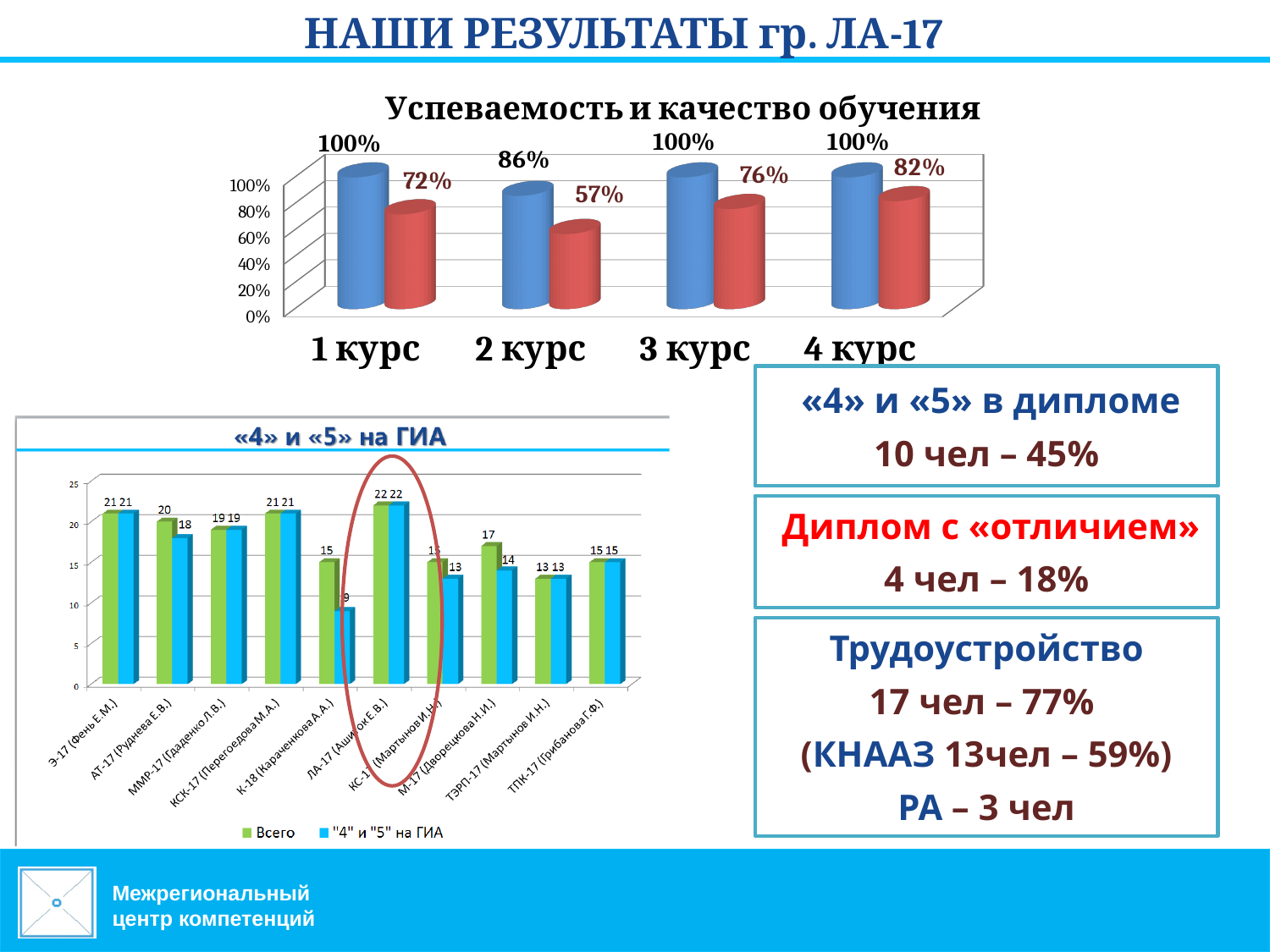
In the chart «Успеваемость и качество обучения», what is the difference between the blue and red bars for 1 курс? 28% In the chart «Успеваемость и качество обучения», what is the value of the blue bar for 2 курс? 86% In the chart «4» и «5» на ГИА, what is the difference between «Всего» and «"4" и "5" на ГИА» for М-17 (Дворецкова Н.И.)? 3 In the chart «4» и «5» на ГИА, how many series does the legend list? 2 In the chart «4» и «5» на ГИА, what is the value of the «Всего» series for ЛА-17 (Ашимок Е.В.)? 22 In the chart «Успеваемость и качество обучения», what is the value of the red bar for 2 курс? 57% In the chart «Успеваемость и качество обучения», which course has the highest red bar value? 4 курс In the chart «4» и «5» на ГИА, what is the value of the «"4" и "5" на ГИА» series for К-18 (Караченкова А.А.)? 9 What type of chart is «4» и «5» на ГИА? Bar chart In the chart «Успеваемость и качество обучения», which course has the lowest blue bar value? 2 курс In the chart «4» и «5» на ГИА, which group has the highest «Всего» value? ЛА-17 (Ашимок Е.В.) In the chart «Успеваемость и качество обучения», how many courses are shown on the x axis? 4